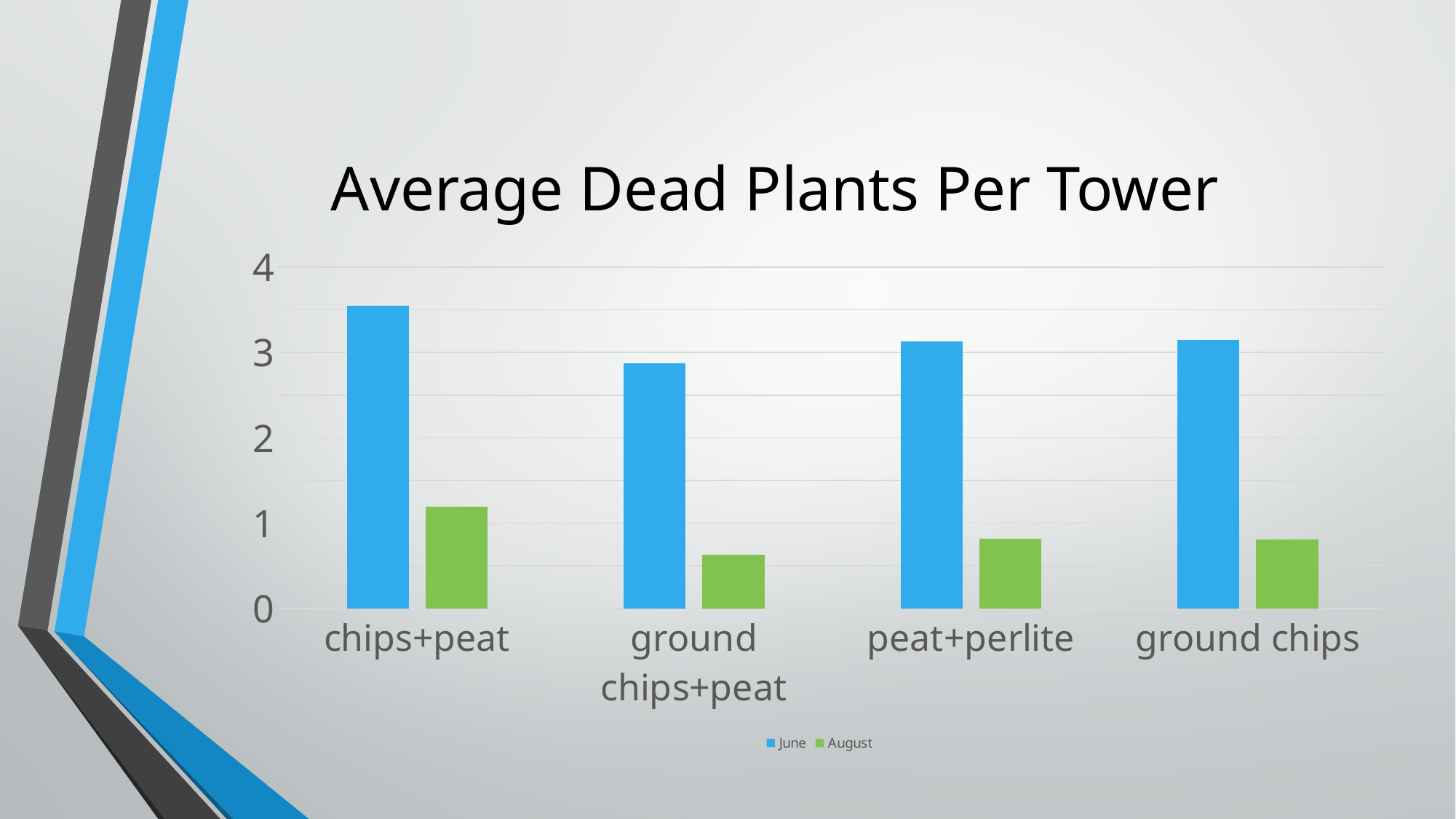
For peat+perlite, which is larger, the June value or the August value? June Which category has the lowest August value? ground chips+peat How many series does the legend list? 2 Which category has the highest August value? chips+peat Is the June value for chips+peat greater or less than 3? greater Which category has the lowest June value? ground chips+peat What is the title of the chart? Average Dead Plants Per Tower Which two series are listed in the legend? June and August How many categories are shown on the x axis? 4 Which category has the highest June value? chips+peat Is the August value for ground chips+peat greater or less than 1? less What kind of chart is shown on the slide? bar chart